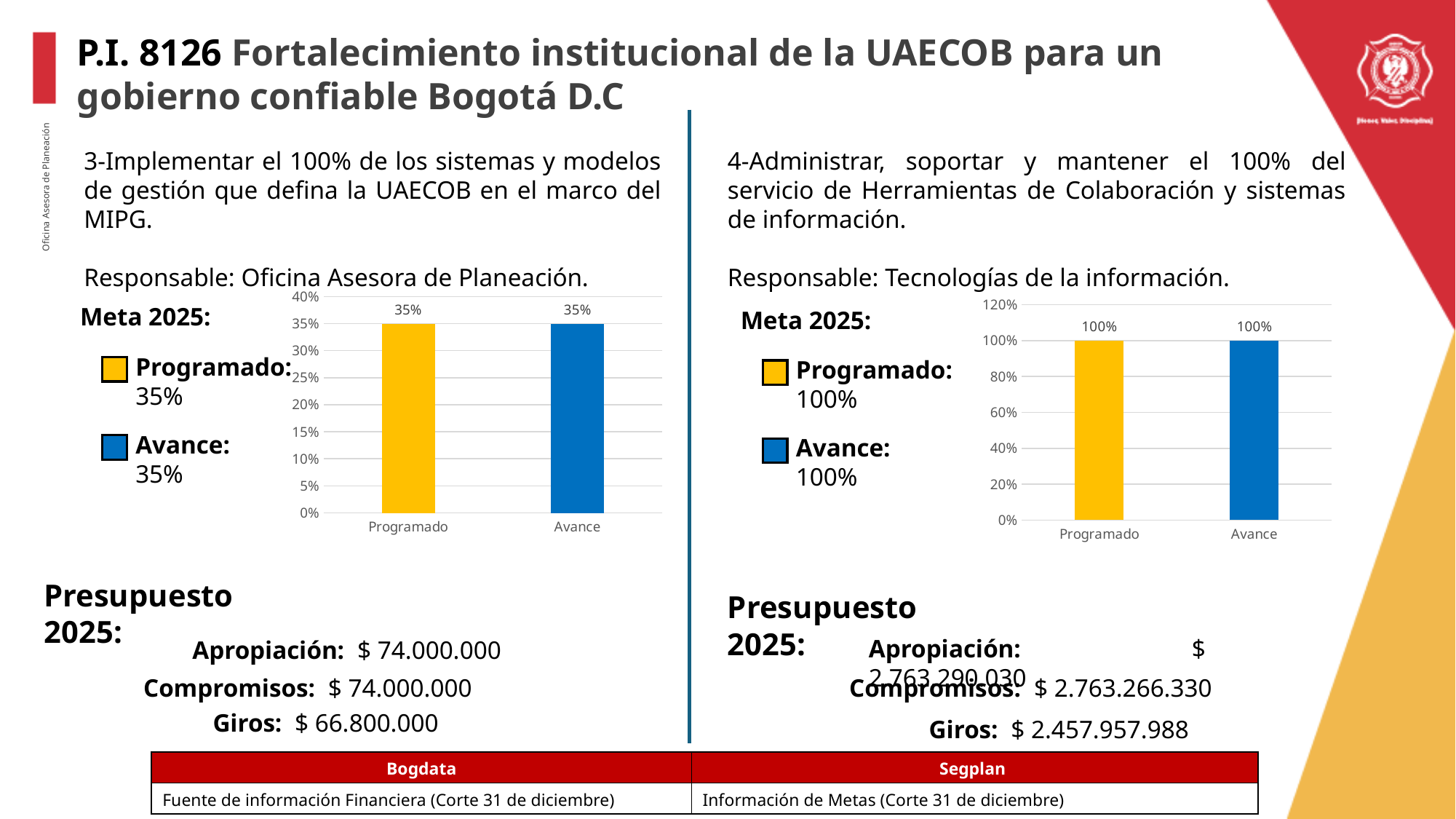
In the right chart, what is the difference between the Programado and Avance values? 0% In the right chart, what is the value for Programado? 100% In the right chart, what is the value for Avance? 100% In the left chart, what is the value for Programado? 35% In the left chart, what colour is the Programado bar? yellow In the right chart, is the value for Programado greater or less than 60%? greater In the left chart, what is the value for Avance? 35% In the left chart, what is the difference between the Programado and Avance values? 0% How many bars are plotted in the left chart? 2 How many categories are shown on the x axis of the right chart? 2 In the left chart, is the value for Avance greater or less than 20%? greater What kind of chart is the right chart? bar chart